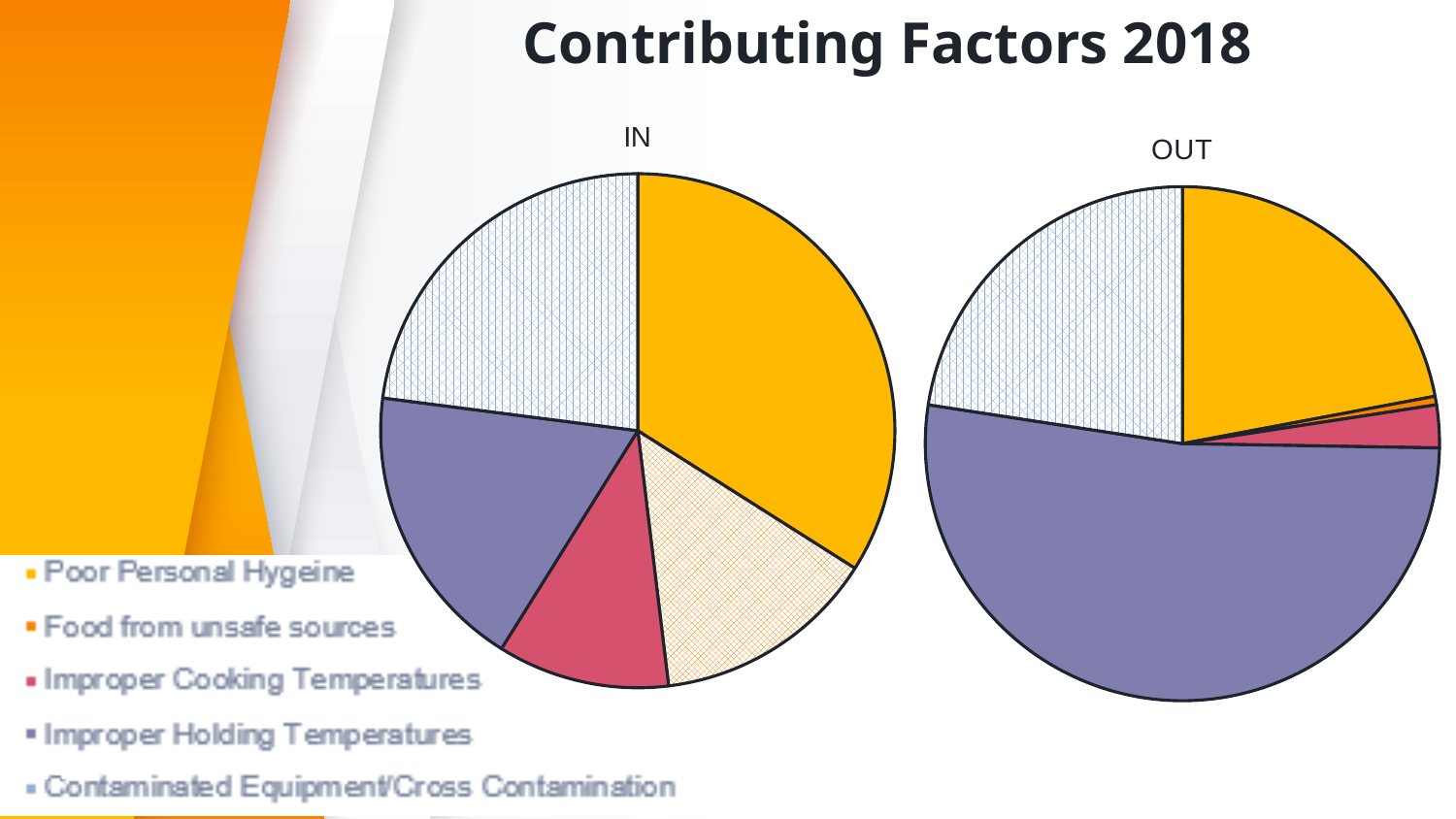
What is the title of the slide? Contributing Factors 2018 Which colour represents Improper Cooking Temperatures in the legend? Red In the IN pie chart, which category has the largest slice? Poor Personal Hygeine In the IN pie chart, which category has the smallest slice? Improper Cooking Temperatures In the OUT pie chart, which category has the smallest slice? Food from unsafe sources How many categories does the legend list? 5 In the OUT pie chart, which slice is larger: Improper Holding Temperatures or Poor Personal Hygeine? Improper Holding Temperatures In the OUT pie chart, which category has the largest slice? Improper Holding Temperatures How many charts are on the slide? 2 What kind of charts are shown on the slide? Pie charts In the IN pie chart, which slice is larger: Poor Personal Hygeine or Improper Holding Temperatures? Poor Personal Hygeine